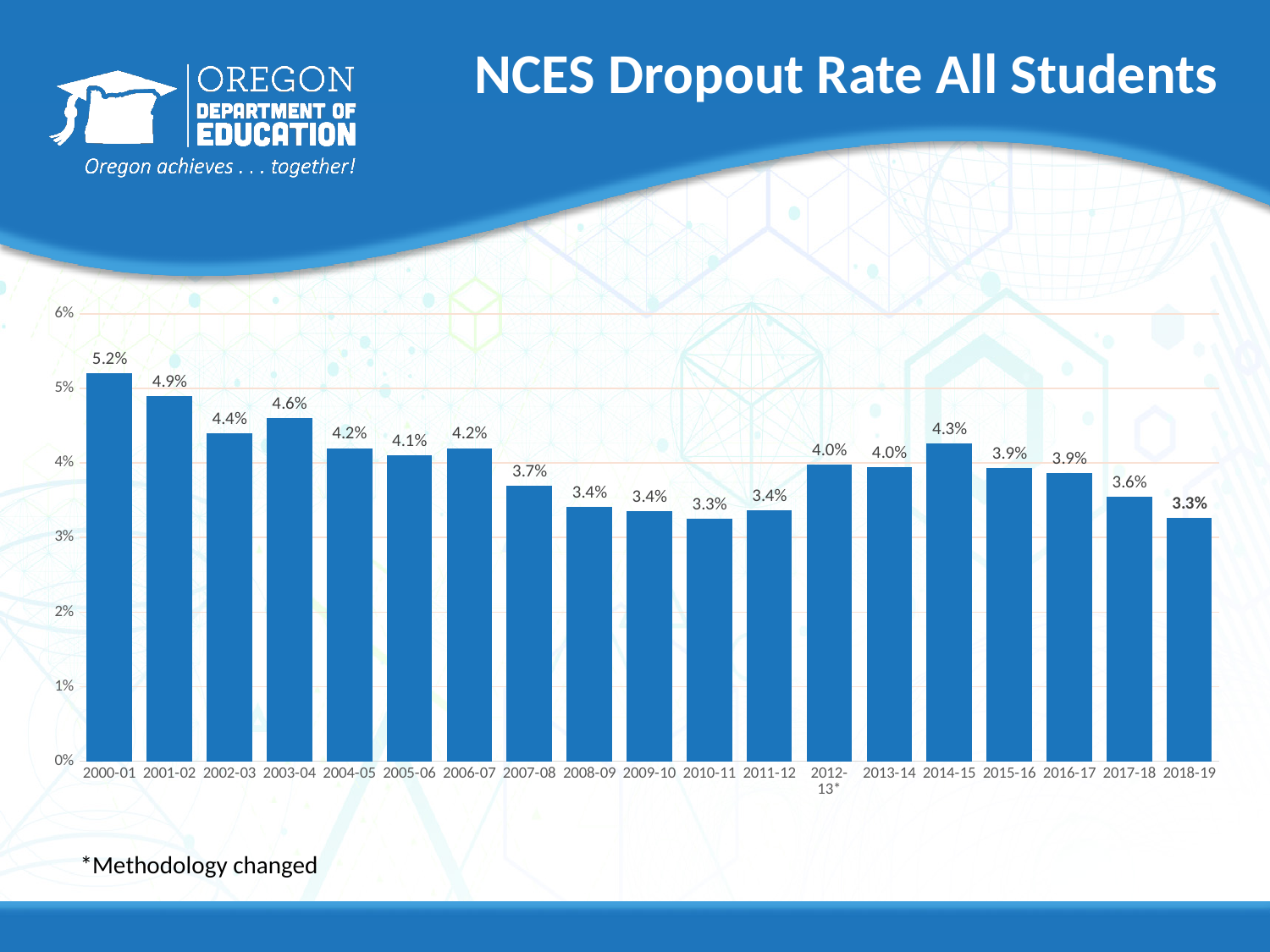
What is the dropout rate for 2014-15? 4.3% How many school years are shown on the chart? 19 What is the dropout rate for 2007-08? 3.7% What is the dropout rate for 2000-01? 5.2% What is the difference between the dropout rates for 2003-04 and 2004-05? 0.4% What is the dropout rate for 2018-19? 3.3% Which is larger, the dropout rate for 2001-02 or for 2013-14? 2001-02 Is the dropout rate for 2009-10 greater or less than 4%? less Which school year has the highest dropout rate? 2000-01 What is the difference between the dropout rates for 2000-01 and 2018-19? 1.9% What is the title of the chart? NCES Dropout Rate All Students What kind of chart is shown on the slide? bar chart